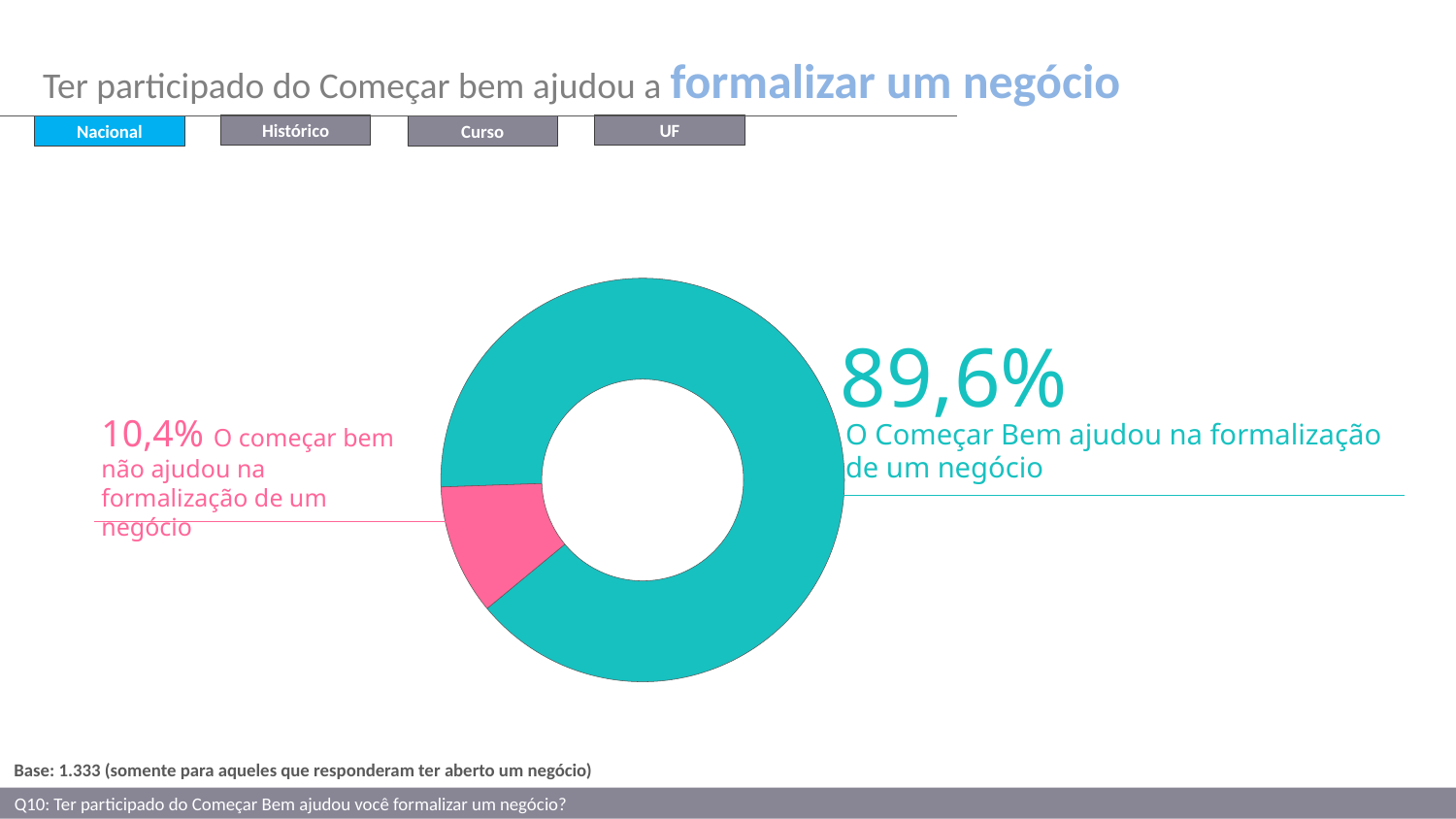
Which slice of the chart is the largest? O Começar Bem ajudou na formalização de um negócio (89,6%) What is the difference in percentage points between the 'helped' and 'did not help' shares? 79,2 percentage points What is the base (number of respondents) stated for this chart? 1.333 Which response has the larger share: helped or did not help in formalizing a business? Helped (89,6%) How many slices does the doughnut chart have? 2 Which slice of the chart is the smallest? O começar bem não ajudou na formalização de um negócio (10,4%) What share of respondents said Começar Bem did not help in formalizing a business? 10,4% What colour is the slice representing those who said Começar Bem helped formalize a business? Teal What share of respondents said Começar Bem helped in formalizing a business? 89,6% What kind of chart is shown on the slide? Doughnut (pie) chart